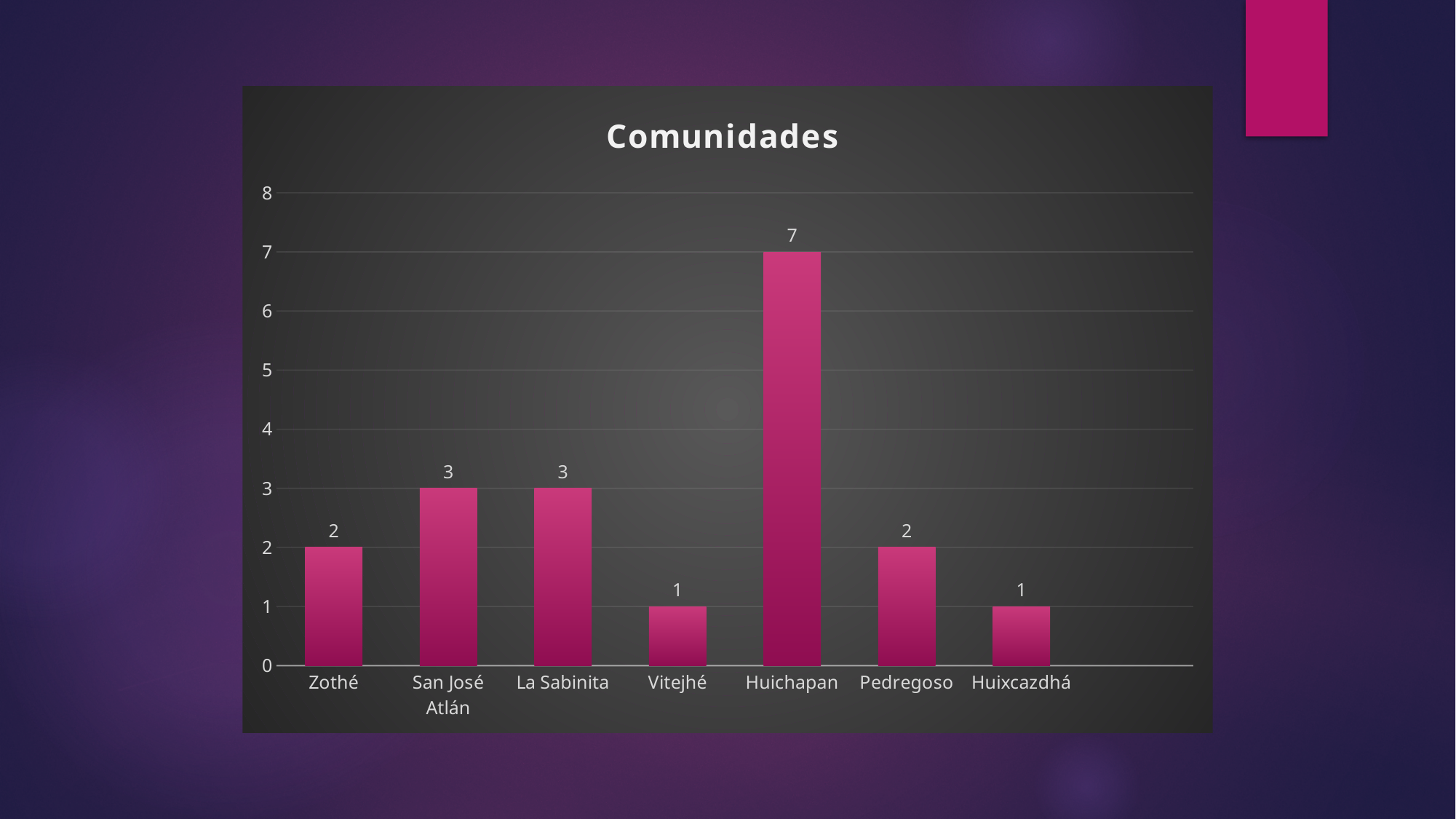
What is the difference between the values for Huichapan and Zothé? 5 Which is larger, the value for La Sabinita or the value for Vitejhé? La Sabinita What is the title of the chart? Comunidades Which community has the highest value? Huichapan What is the value for Huichapan? 7 What is the value for Pedregoso? 2 How many communities have a value of 1? 2 What is the value for San José Atlán? 3 What is the difference between the values for San José Atlán and Huixcazdhá? 2 How many communities are shown on the x axis? 7 What kind of chart is shown on the slide? bar chart Is the value for Huichapan greater or less than 5? greater